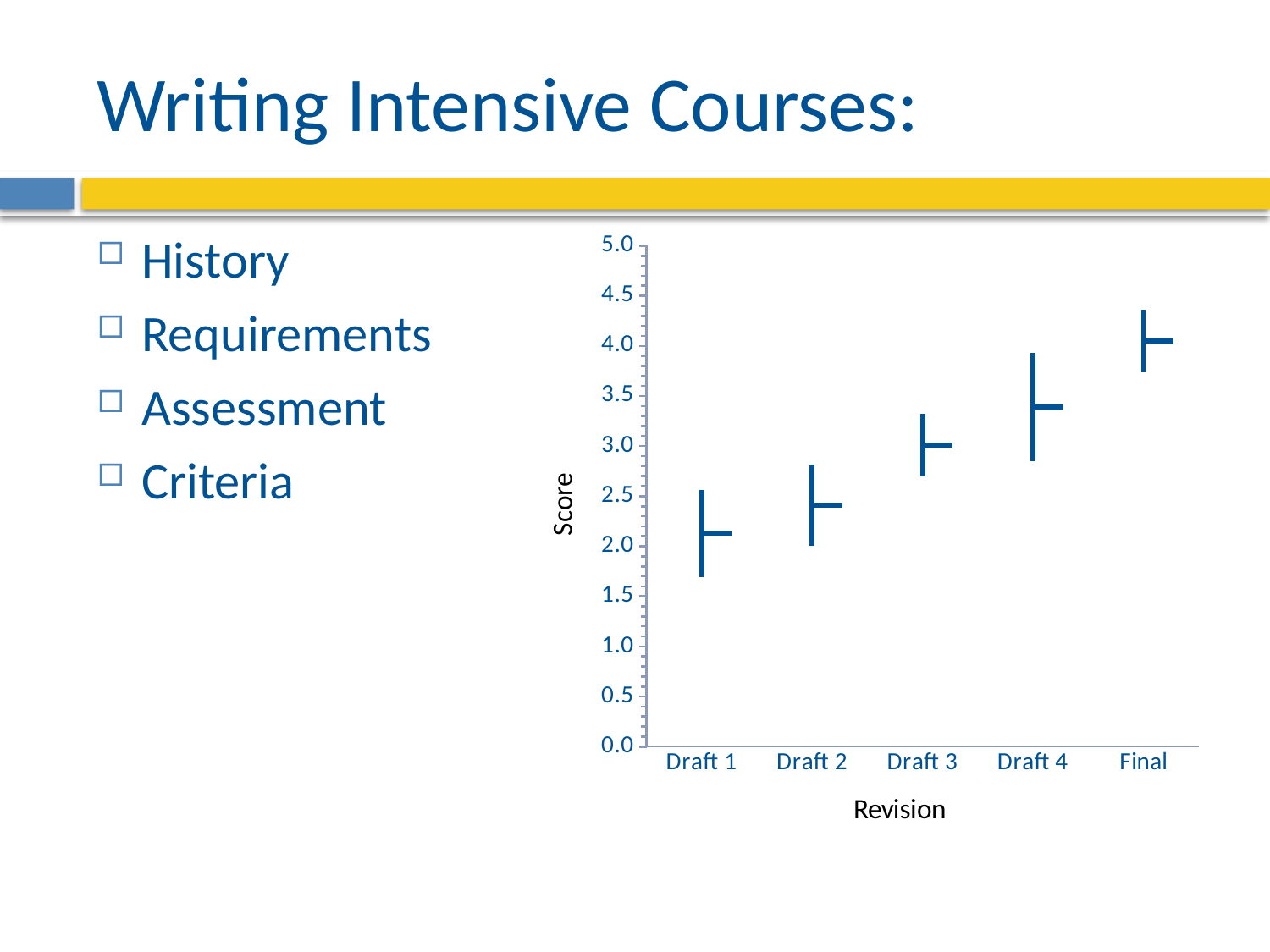
Is the score for Draft 3 greater or less than 2.5? greater Is the score for Draft 1 greater or less than 2.5? less Which has a higher score, Draft 2 or Draft 4? Draft 4 Which revision has the lowest score? Draft 1 Which revision has the highest score? Final Is the score for Draft 2 greater or less than 2.0? greater What is the label of the x axis? Revision How many revisions are plotted on the x axis? 5 What is the label of the y axis? Score Do the scores rise or fall from Draft 1 to Final? rise